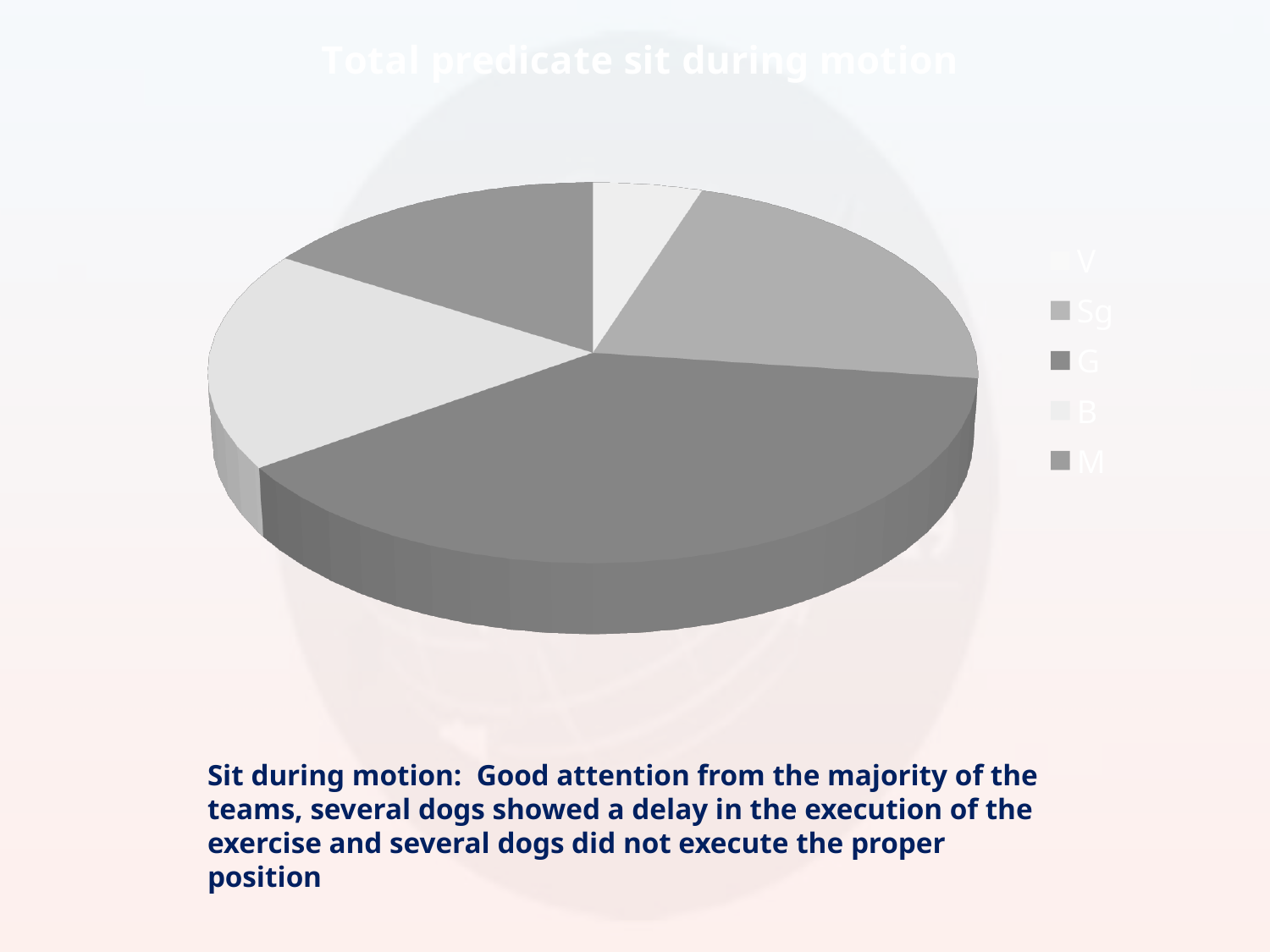
What kind of chart is shown on the slide? pie chart Which slice is larger, M or V? M Which category has the largest slice of the pie? G How many entries does the chart legend list? 5 What is the title of the chart? Total predicate sit during motion Which slice is larger, G or V? G Which slice is larger, G or Sg? G How many slices does the pie chart have? 5 Which category has the smallest slice of the pie? V What are the legend entries of the chart, in order? V, Sg, G, B, M